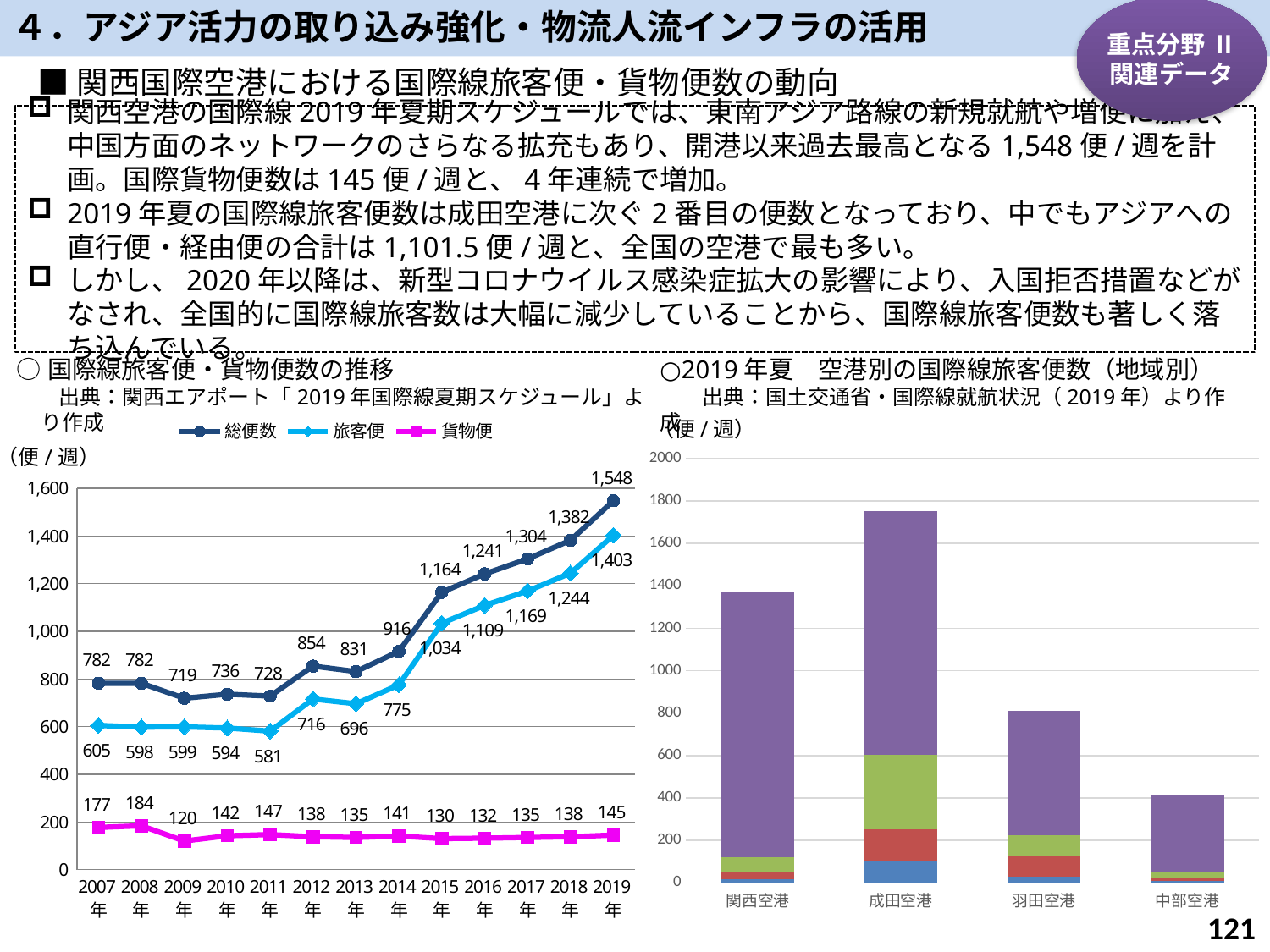
In the right chart (2019年夏 空港別の国際線旅客便数), how many airports are shown? 4 In the left chart (国際線旅客便・貨物便数の推移), how many years are shown on the x axis? 13 In the left chart (国際線旅客便・貨物便数の推移), which year has the lowest 旅客便 value? 2011年 In the left chart (国際線旅客便・貨物便数の推移), what is the difference between 総便数 and 旅客便 in 2019年? 145 In the left chart (国際線旅客便・貨物便数の推移), what is the value of 旅客便 in 2015年? 1,034 In the left chart (国際線旅客便・貨物便数の推移), what is the value of 総便数 in 2019年? 1,548 In the right chart (2019年夏 空港別の国際線旅客便数), is the total bar for 関西空港 greater or less than 1200? greater In the left chart (国際線旅客便・貨物便数の推移), what is the value of 貨物便 in 2009年? 120 In the left chart (国際線旅客便・貨物便数の推移), which year has the highest 貨物便 value? 2008年 In the left chart (国際線旅客便・貨物便数の推移), what kind of chart is it? Line chart In the right chart (2019年夏 空港別の国際線旅客便数), which airport has the tallest bar? 成田空港 In the left chart (国際線旅客便・貨物便数の推移), how many series does the legend list? 3